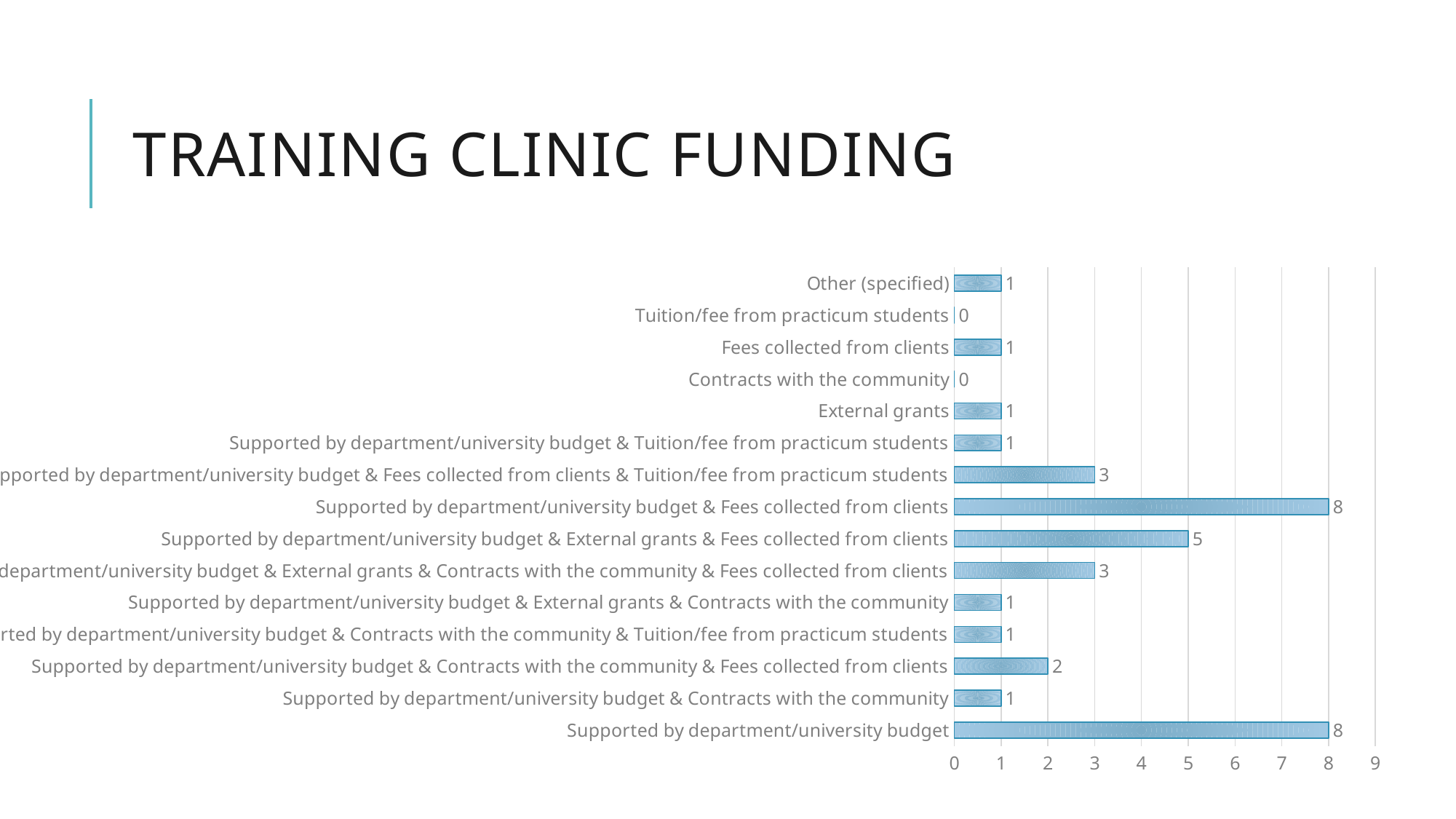
What is the difference between the values for "Supported by department/university budget" and "Supported by department/university budget & Contracts with the community & Fees collected from clients"? 6 What is the value for "Supported by department/university budget & Contracts with the community & Fees collected from clients"? 2 What is the value for "Supported by department/university budget & External grants & Fees collected from clients"? 5 What type of chart is shown on the slide? Bar chart What is the value for "Supported by department/university budget & Fees collected from clients"? 8 How many categories are plotted on the chart? 15 What is the value for "External grants"? 1 What is the difference between the values for "Supported by department/university budget & Fees collected from clients" and "Supported by department/university budget & External grants & Fees collected from clients"? 3 What is the title of the slide containing the chart? TRAINING CLINIC FUNDING What is the value for "Supported by department/university budget"? 8 What is the value for "Tuition/fee from practicum students"? 0 Which is larger: the value for "Supported by department/university budget & Contracts with the community & Fees collected from clients" or the value for "Supported by department/university budget & Contracts with the community"? Supported by department/university budget & Contracts with the community & Fees collected from clients